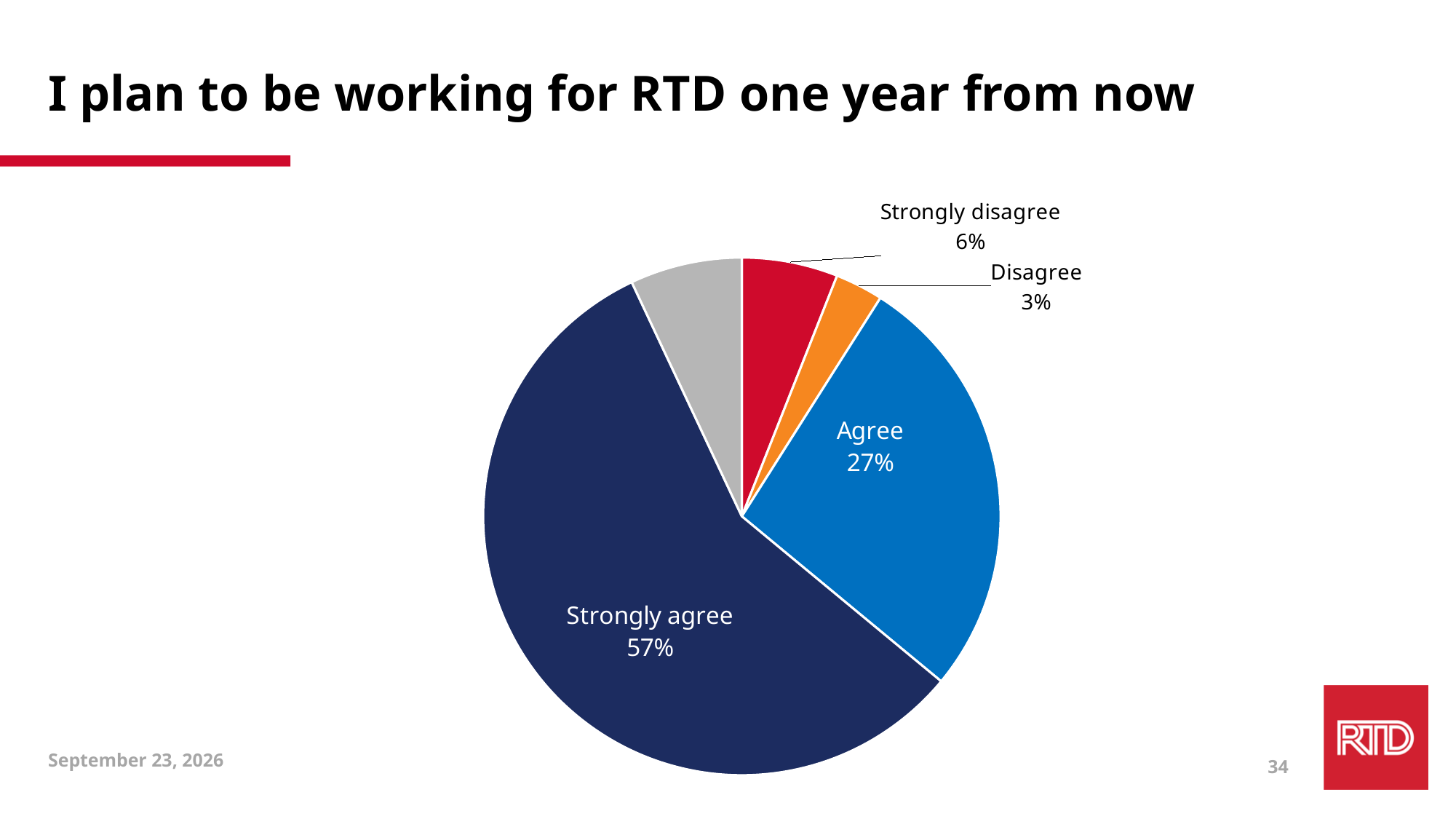
What share of respondents chose "Disagree"? 3% What is the combined share of "Strongly agree" and "Agree"? 84% How many slices does the pie chart have? 5 What share of respondents chose "Strongly agree"? 57% What is the difference in percentage points between "Strongly agree" and "Agree"? 30 Which labelled response has the largest share of the pie? Strongly agree What share of respondents chose "Agree"? 27% What share of respondents chose "Strongly disagree"? 6% What is the title of the slide containing the chart? I plan to be working for RTD one year from now What kind of chart is shown on the slide? Pie chart Which labelled response has the smallest share of the pie? Disagree Which is larger, the share for "Strongly disagree" or the share for "Disagree"? Strongly disagree